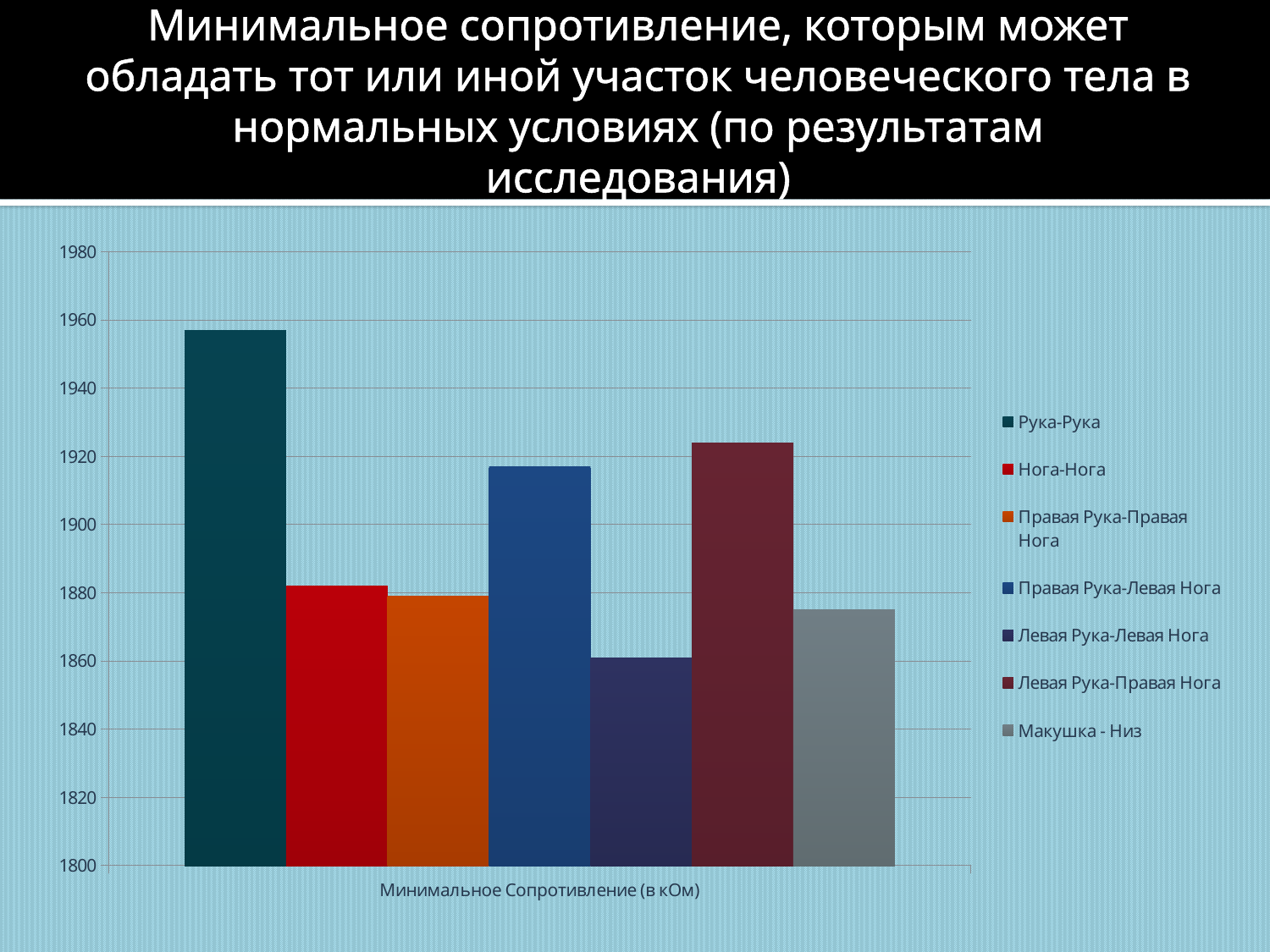
Which is larger, the value for Рука-Рука or the value for Нога-Нога? Рука-Рука Which is larger, the value for Макушка - Низ or the value for Левая Рука-Левая Нога? Макушка - Низ Which series has the lowest minimum resistance value? Левая Рука-Левая Нога How many series does the legend list? 7 Is the value for Макушка - Низ greater or less than 1900? less Is the value for Рука-Рука greater or less than 1940? greater What colour is the bar for Нога-Нога? red What is the label shown under the x axis of the chart? Минимальное Сопротивление (в кОм) Which series has the highest minimum resistance value? Рука-Рука What kind of chart is shown on the slide? bar chart Is the value for Левая Рука-Левая Нога greater or less than 1880? less